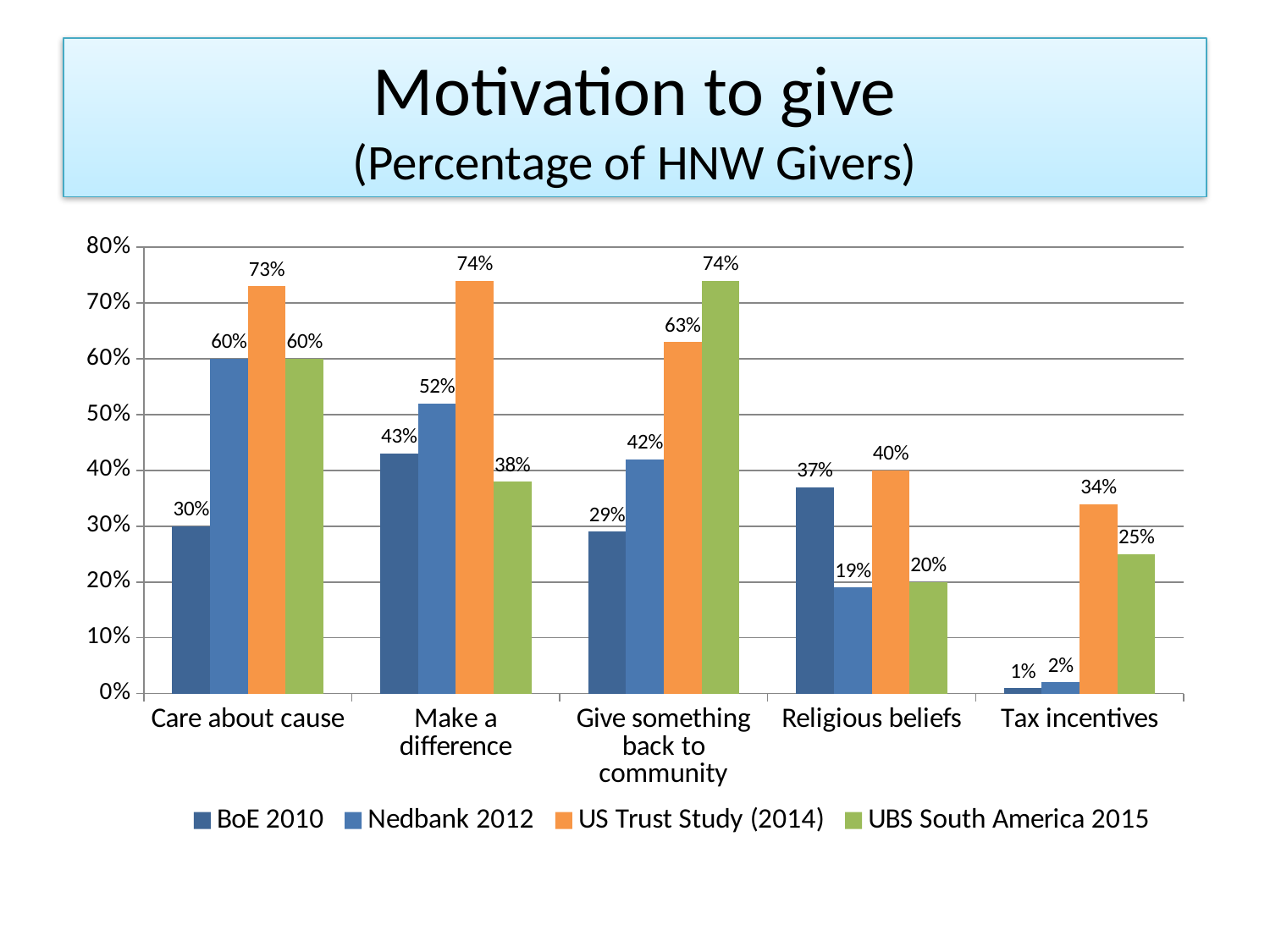
How many categories are shown on the x axis? 5 What is the title of the chart on the slide? Motivation to give (Percentage of HNW Givers) What is the value for BoE 2010 in the Religious beliefs category? 37% Which category has the highest value for the Nedbank 2012 series? Care about cause What is the value for UBS South America 2015 in the Tax incentives category? 25% What is the difference between the US Trust Study (2014) and BoE 2010 values in the Make a difference category? 31% What is the difference between the Nedbank 2012 and BoE 2010 values in the Tax incentives category? 1% How many series does the legend list? 4 What kind of chart is shown on the slide? Bar chart Which category has the lowest value for the US Trust Study (2014) series? Tax incentives What is the value for US Trust Study (2014) in the Care about cause category? 73% In the Give something back to community category, which series has the larger value: US Trust Study (2014) or UBS South America 2015? UBS South America 2015